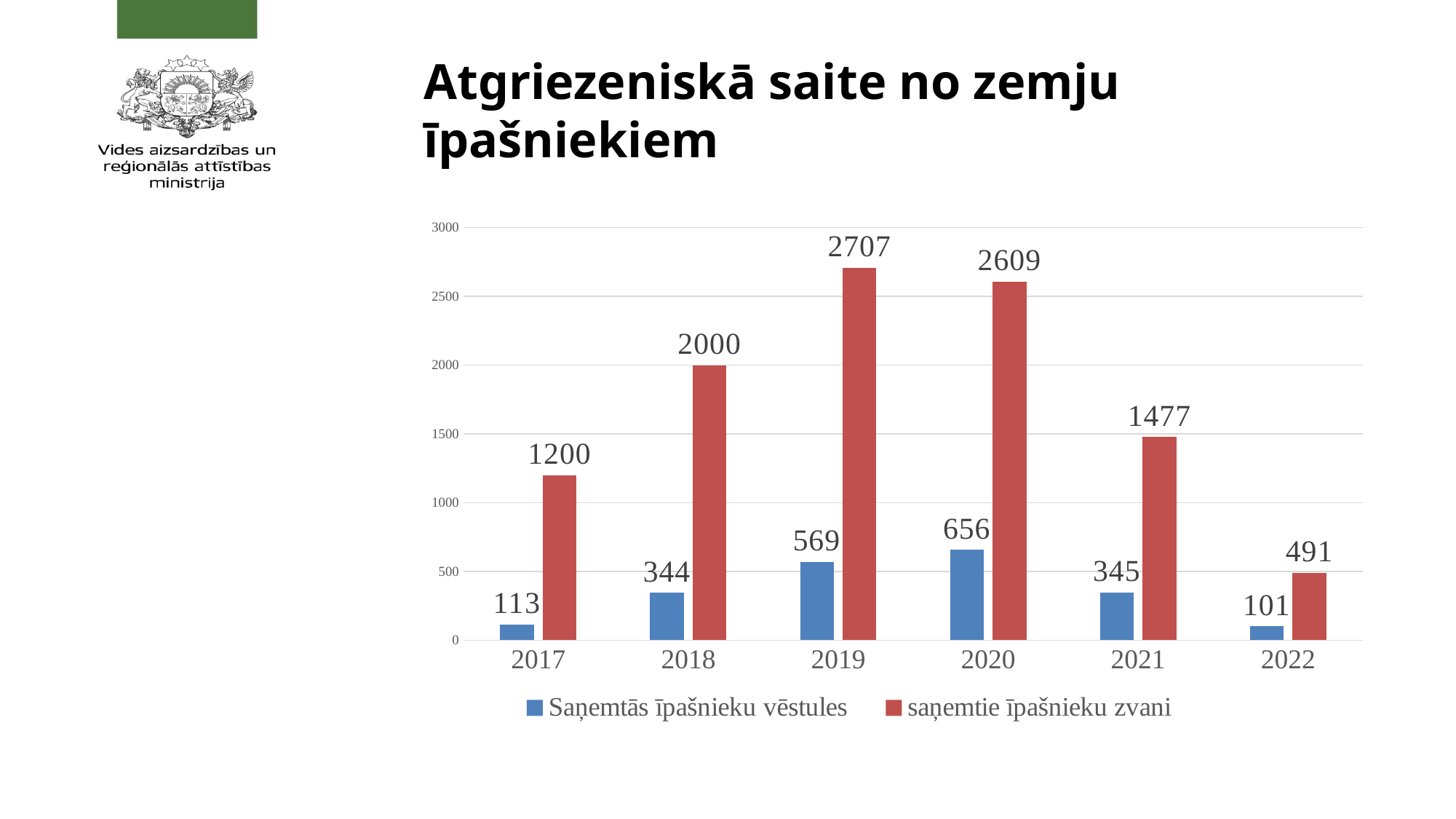
Is the value for 'saņemtie īpašnieku zvani' in 2021 greater or less than 1500? less How many series does the legend list? 2 What is the value for 'saņemtie īpašnieku zvani' in 2019? 2707 What is the value for 'Saņemtās īpašnieku vēstules' in 2020? 656 Does 'saņemtie īpašnieku zvani' rise or fall from 2020 to 2022? fall What kind of chart is shown on the slide? bar chart What is the value for 'saņemtie īpašnieku zvani' in 2022? 491 What is the difference between 'saņemtie īpašnieku zvani' and 'Saņemtās īpašnieku vēstules' in 2018? 1656 In which year is 'Saņemtās īpašnieku vēstules' lowest? 2022 How many years are shown on the x axis? 6 Which is larger: 'Saņemtās īpašnieku vēstules' in 2019 or in 2021? 2019 In which year is 'saņemtie īpašnieku zvani' highest? 2019